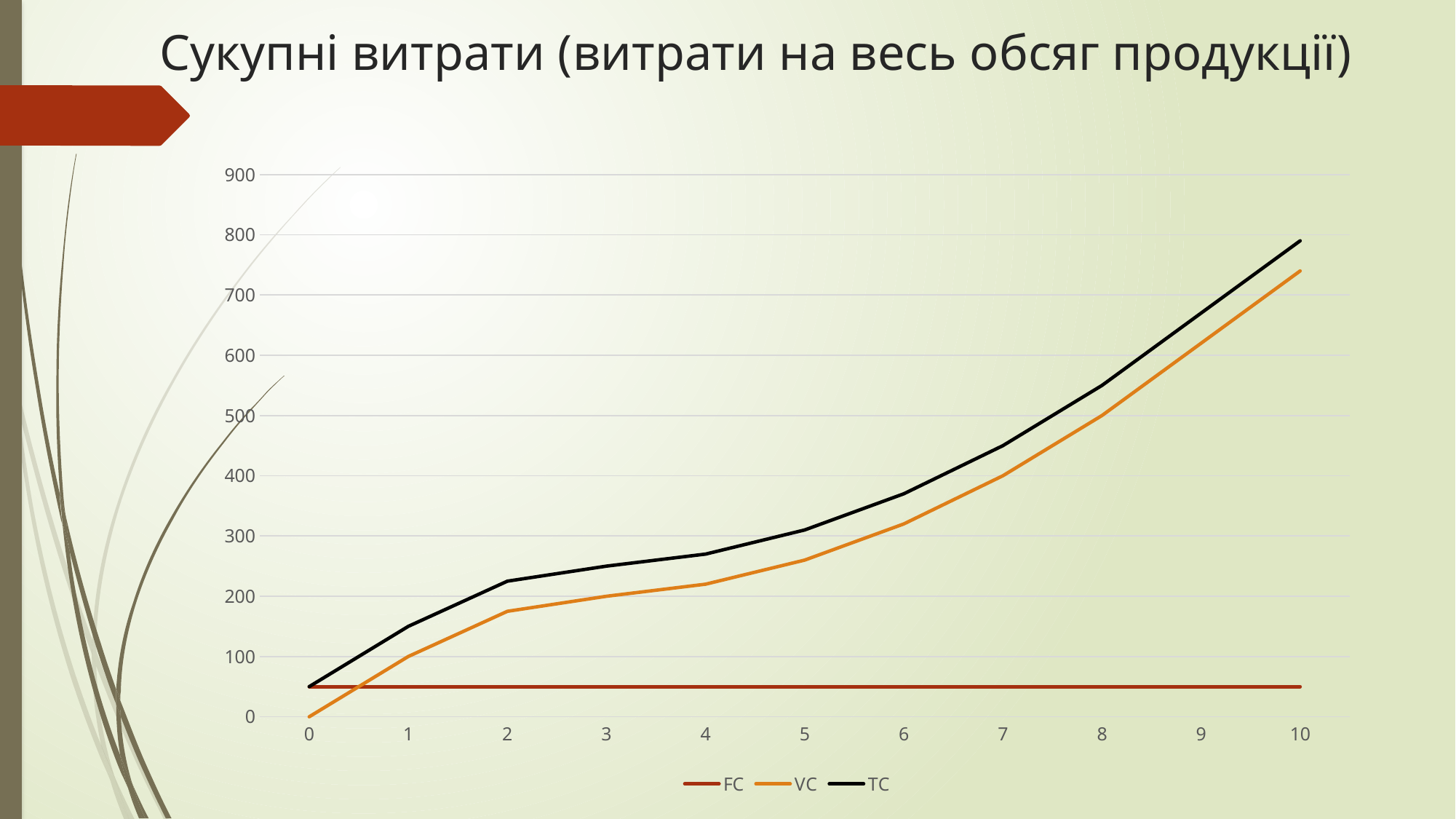
What is the title of the chart? Сукупні витрати (витрати на весь обсяг продукції) How many series does the legend list? 3 Is the value of TC at x = 10 greater or less than 700? greater Which series has the highest value at x = 10? TC Is the value of FC at x = 5 greater or less than 100? less How many points along the x axis does each series have? 11 Is the value of VC at x = 2 greater or less than 200? less At x = 8, which is larger, FC or VC? VC What kind of chart is shown on the slide? line chart What is the value of VC at x = 0? 0 Does the TC series rise or fall as the x axis goes from 0 to 10? rise